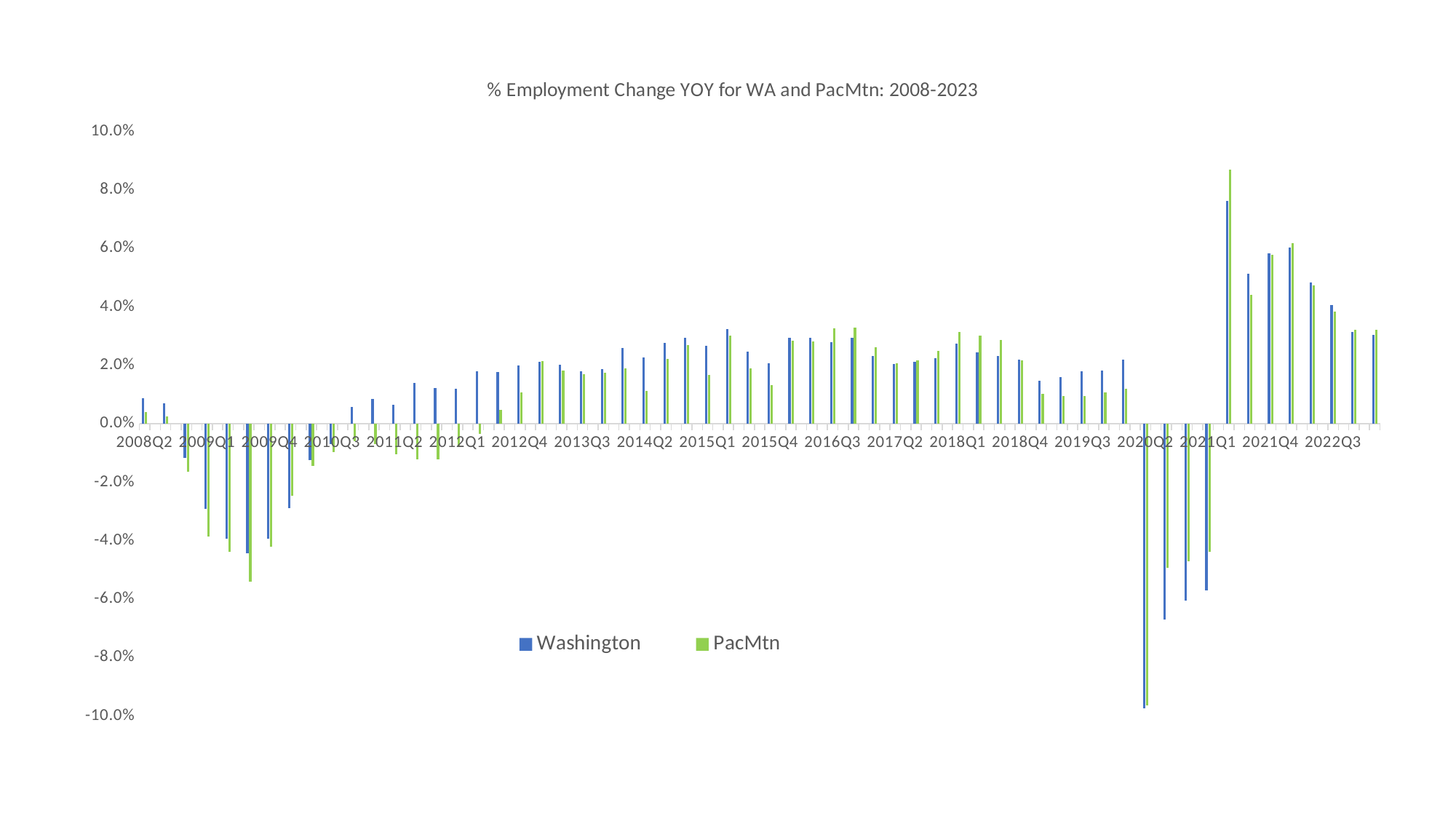
Is the value for Washington at 2020Q2 greater or less than -8.0%? less Is the value for PacMtn at 2021Q4 greater or less than 4.0%? greater What kind of chart is shown on the slide? bar chart Is the value for PacMtn at 2009Q4 greater or less than -2.0%? less At 2015Q1, which series has the larger value, Washington or PacMtn? Washington In which labeled quarter does the Washington series reach its lowest value? 2020Q2 What is the title of the chart? % Employment Change YOY for WA and PacMtn: 2008-2023 How many series does the legend list? 2 At 2009Q4, which series has the larger value, Washington or PacMtn? Washington Which colour represents the PacMtn series in the legend? green